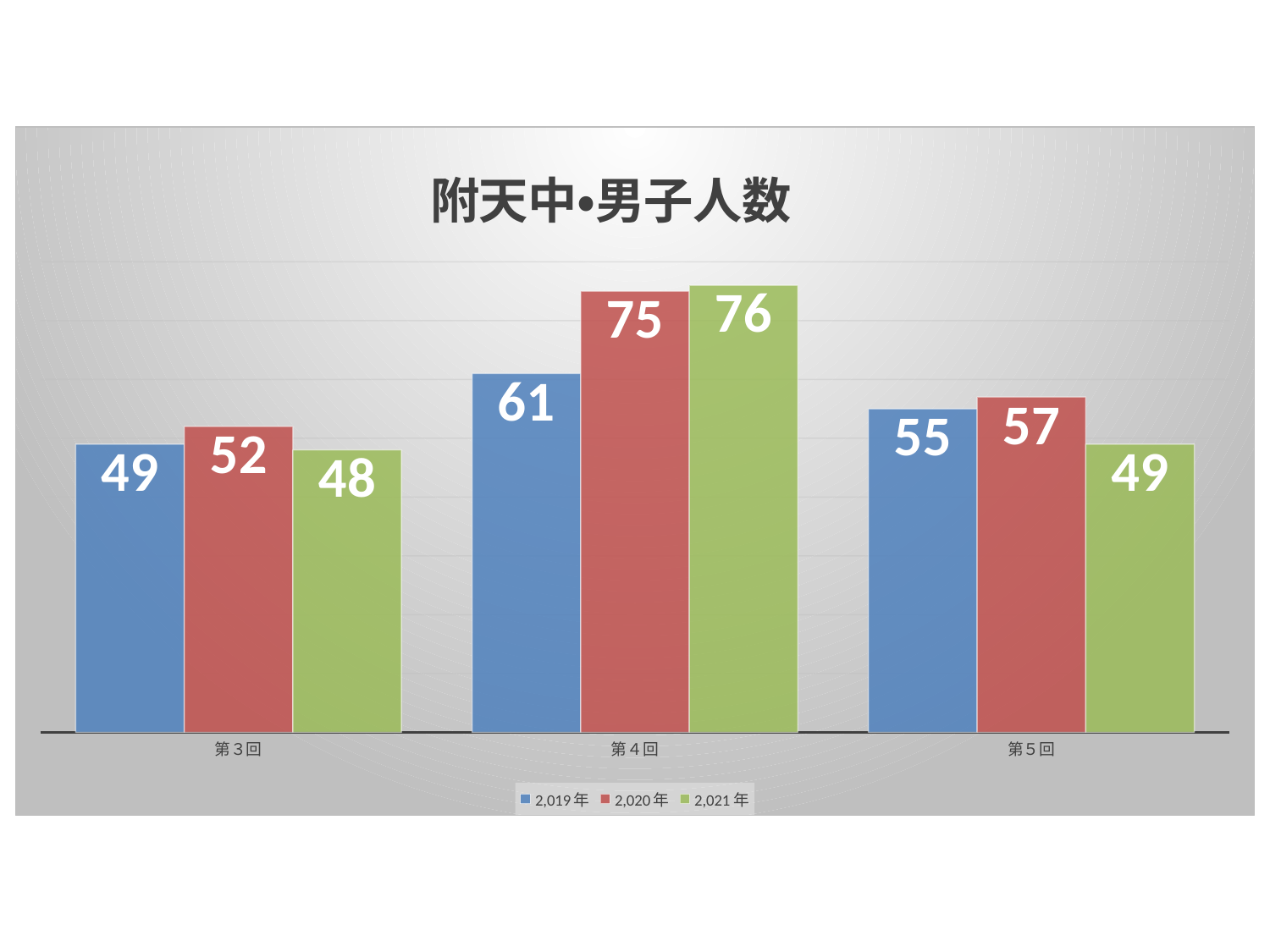
Which colour represents 2,020年 in the legend? red Which category has the lowest value for 2,019年? 第3回 What kind of chart is shown? bar chart What is the title of the chart? 附天中•男子人数 What is the value for 2,021年 in 第3回? 48 How many series does the legend list? 3 What is the value for 2,019年 in 第4回? 61 How many categories are shown on the x axis? 3 What is the value for 2,020年 in 第5回? 57 What is the difference between the 2,020年 and 2,019年 values in 第4回? 14 Which is larger in 第5回: the value for 2,019年 or 2,021年? 2,019年 Which category has the highest value for 2,021年? 第4回